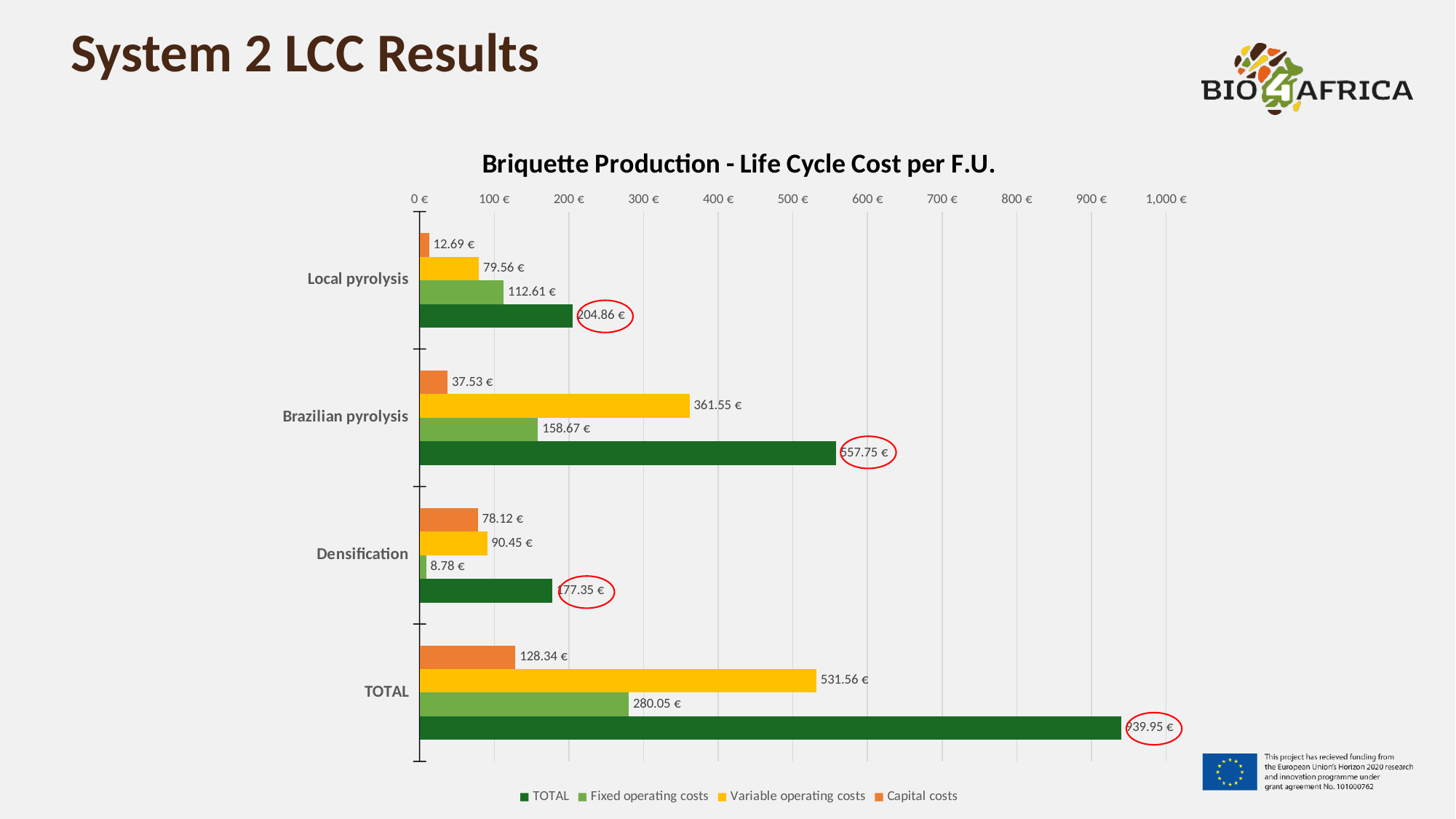
What type of chart is shown on the slide? Bar chart How many series does the legend list? 4 What is the TOTAL value for Brazilian pyrolysis? 557.75 € What is the difference between the Variable operating costs of Brazilian pyrolysis and Local pyrolysis? 281.99 € Which is larger for Densification: Capital costs or Variable operating costs? Variable operating costs What are the Fixed operating costs in the TOTAL category? 280.05 € Is the TOTAL value for the TOTAL category greater or less than 900 €? greater Which category has the lowest Fixed operating costs? Densification Among Local pyrolysis, Brazilian pyrolysis and Densification, which has the highest TOTAL value? Brazilian pyrolysis What are the Capital costs for Densification? 78.12 € How many categories are shown on the vertical axis? 4 What are the Variable operating costs for Local pyrolysis? 79.56 €